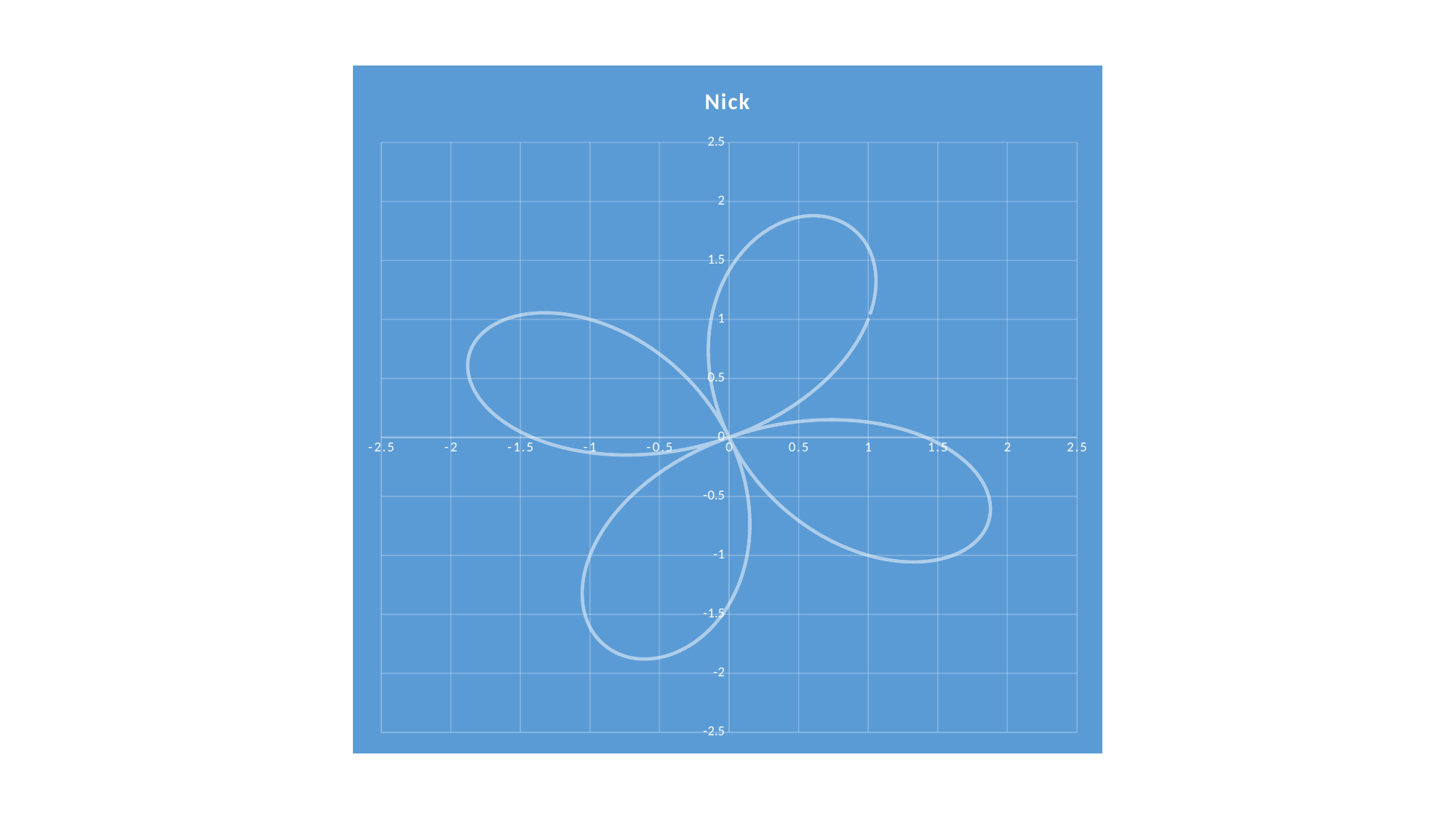
What is the maximum value shown on the vertical axis? 2.5 Is the largest x value reached by the curve greater or less than 1.5? greater What is the title of the chart? Nick Is the highest y value reached by the curve greater or less than 1.5? greater Is the highest y value reached by the curve greater or less than 2? less What kind of chart is shown on the slide? scatter chart with smooth lines How many petals (loops) does the curve on the chart form? 4